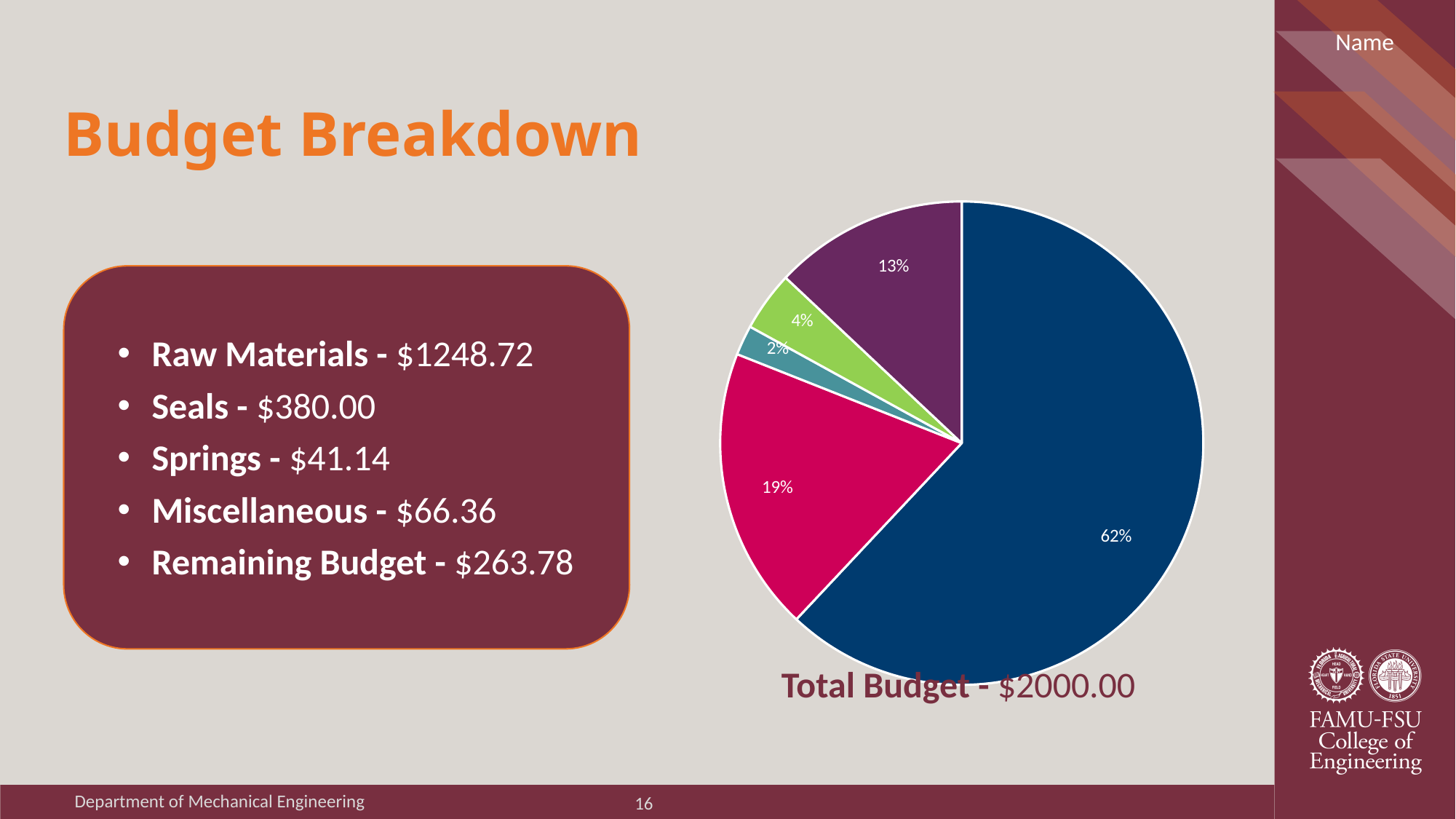
What percentage is labelled on the dark blue slice of the pie chart? 62% Which slice is larger, the purple slice or the green slice? the purple slice What total budget is stated beneath the pie chart? $2000.00 What percentage is labelled on the green slice of the pie chart? 4% What percentage is labelled on the teal slice of the pie chart? 2% What kind of chart is shown on the slide? pie chart What percentage is labelled on the purple slice of the pie chart? 13% How many slices does the pie chart have? 5 By how many percentage points does the 62% slice exceed the 19% slice? 43 percentage points What is the share of the largest slice in the pie chart? 62% What percentage is labelled on the magenta slice of the pie chart? 19% What is the share of the smallest slice in the pie chart? 2%